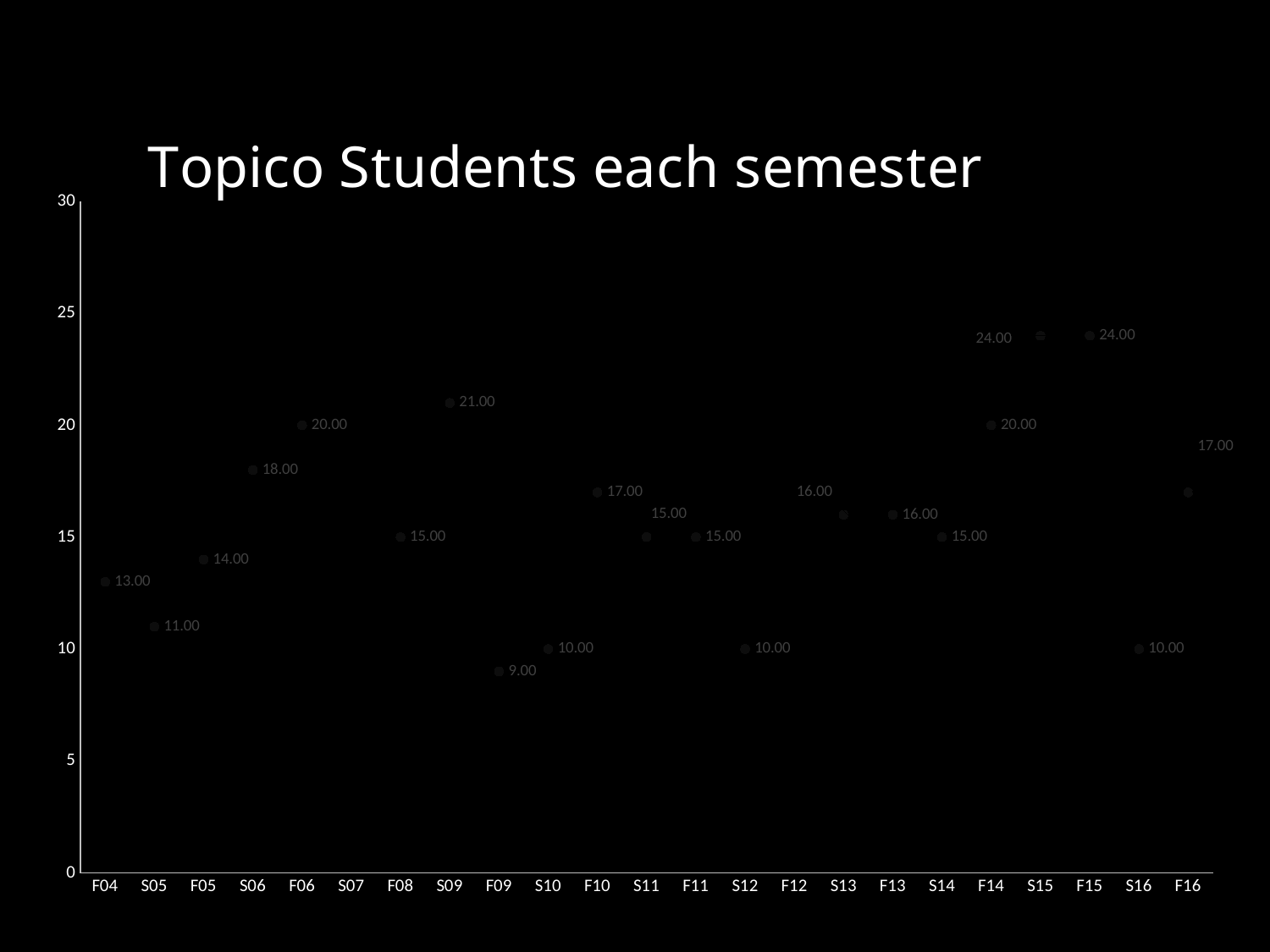
How many semesters are labelled on the x axis? 23 Which is larger, the value for S09 or the value for F10? S09 What is the difference between the values for F06 and F04? 7.00 Which semester has the lowest value? F09 What is the title of the chart? Topico Students each semester What is the value for S09? 21.00 What is the value for F04? 13.00 Is the value for S06 greater or less than 15? greater What is the value for F09? 9.00 What is the value for F14? 20.00 What is the value for F15? 24.00 What is the highest value plotted on the chart? 24.00